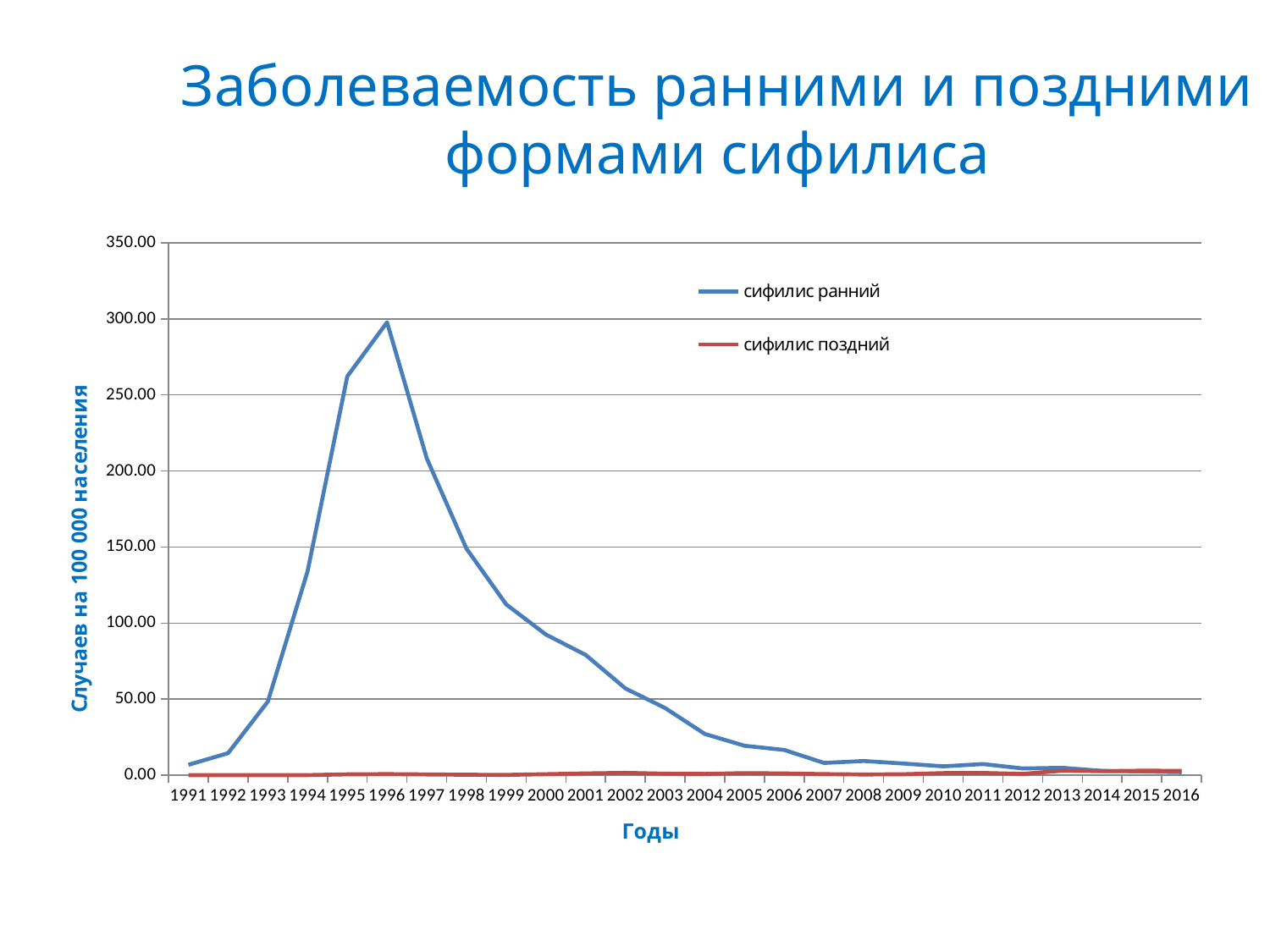
What kind of chart is shown on the slide? line chart Is the value for 'сифилис ранний' in 1996 greater or less than 250? greater Is the value for 'сифилис ранний' in 1993 greater or less than 100? less In which year does the series 'сифилис ранний' reach its highest value? 1996 What is the title of the vertical axis? Случаев на 100 000 населения How many series does the legend list? 2 Does the series 'сифилис ранний' rise or fall from 1991 to 1996? rise Is the value for 'сифилис ранний' in 1998 greater or less than 100? greater How many years are plotted along the x axis? 26 Does the series 'сифилис ранний' rise or fall from 1996 to 2016? fall Which is larger for 'сифилис ранний': the value in 1994 or the value in 2000? 1994